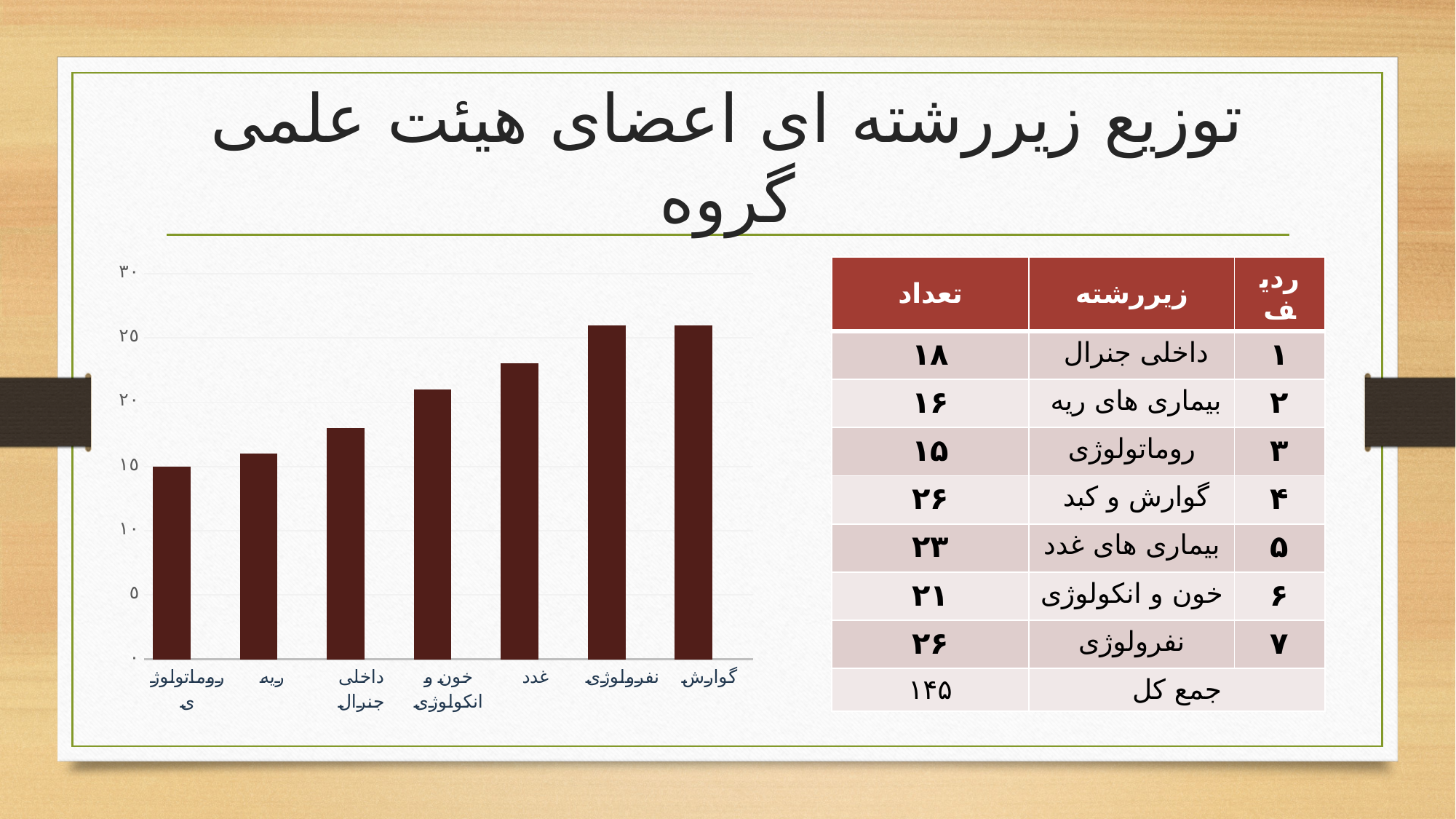
Which is larger, the bar for خون و انکولوژی or the bar for ریه? خون و انکولوژی What is the value of the bar for غدد? ۲۳ Do the bar values rise or fall from left to right along the x axis? rise Is the value for داخلی جنرال greater or less than ۲۰? less What kind of chart is shown on the slide? bar chart Which is larger, the bar for غدد or the bar for داخلی جنرال? غدد What is the value of the bar for روماتولوژی? ۱۵ Which category has the lowest bar in the chart? روماتولوژی How many categories (bars) does the chart show? 7 Is the value for نفرولوژی greater or less than ۲۵? greater Is the value for غدد greater or less than ۲۰? greater What is the title of the slide containing the chart? توزیع زیررشته ای اعضای هیئت علمی گروه